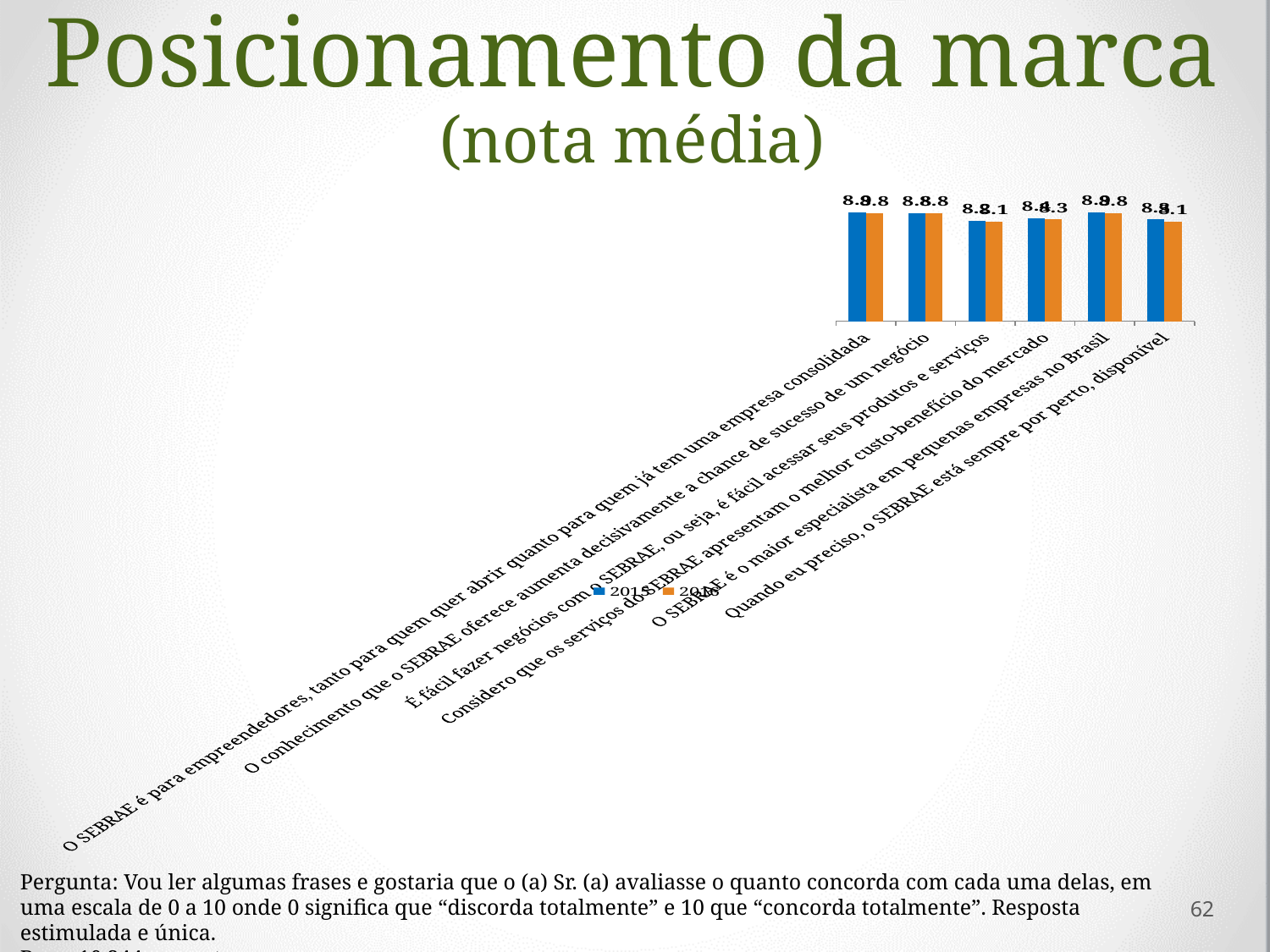
What colour are the bars for the 2016 series? orange What is the 2015 value for "Quando eu preciso, o SEBRAE está sempre por perto, disponível"? 8.3 For 2015, which is larger: the value for "O SEBRAE é o maior especialista em pequenas empresas no Brasil" or for "Considero que os serviços do SEBRAE apresentam o melhor custo-benefício do mercado"? O SEBRAE é o maior especialista em pequenas empresas no Brasil Which statement has the lowest 2015 value? É fácil fazer negócios com o SEBRAE, ou seja, é fácil acessar seus produtos e serviços What is the 2015 value for "Considero que os serviços do SEBRAE apresentam o melhor custo-benefício do mercado"? 8.4 What is the 2015 value for "O SEBRAE é o maior especialista em pequenas empresas no Brasil"? 8.9 What is the 2015 value for "É fácil fazer negócios com o SEBRAE, ou seja, é fácil acessar seus produtos e serviços"? 8.2 Which two years are listed in the chart legend? 2015 and 2016 What is the difference between the 2015 values for "O SEBRAE é o maior especialista em pequenas empresas no Brasil" and "É fácil fazer negócios com o SEBRAE, ou seja, é fácil acessar seus produtos e serviços"? 0.7 How many statements (categories) are plotted on the chart? 6 How many series does the chart legend list? 2 What kind of chart is shown on the slide? bar chart